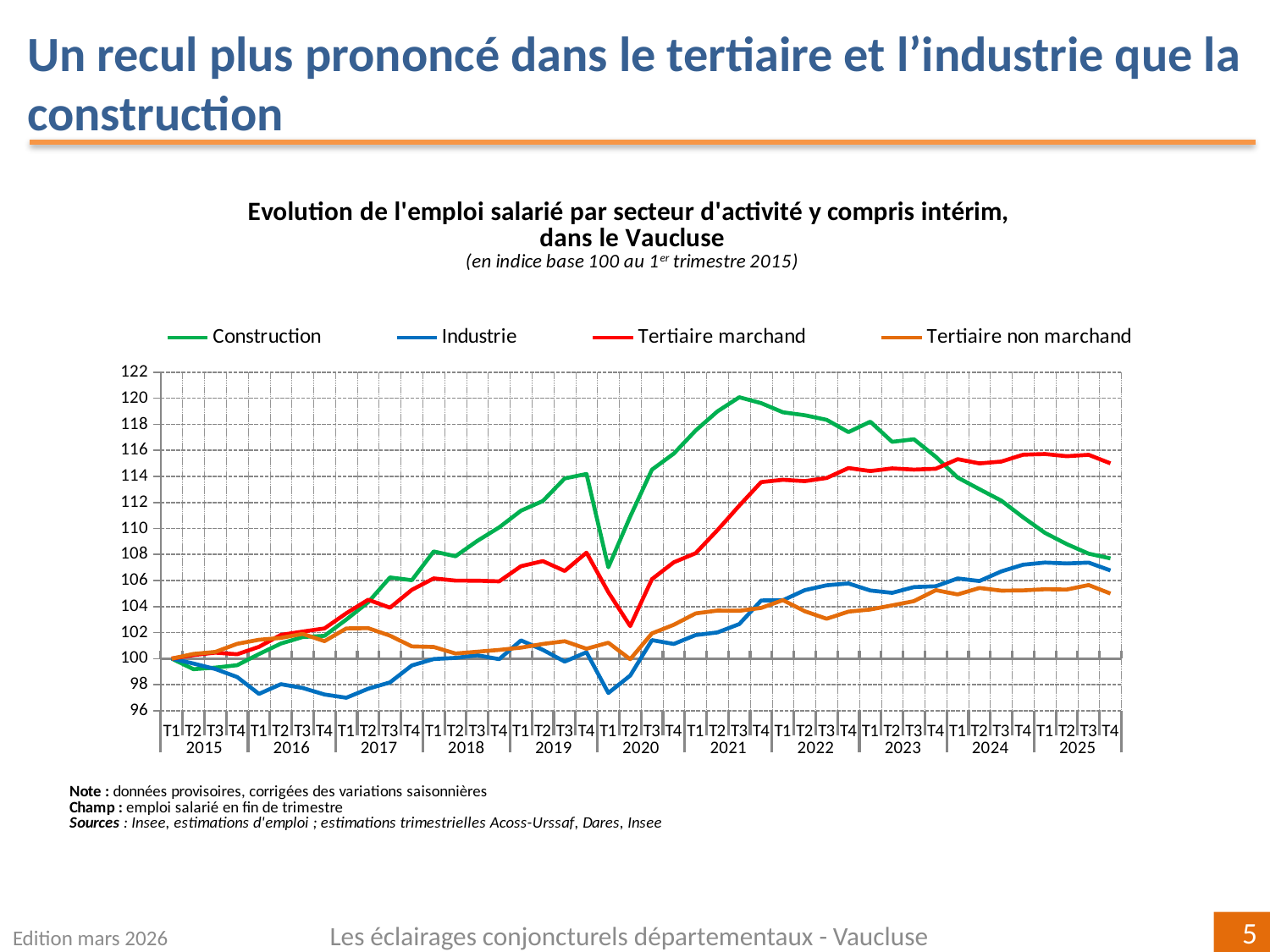
Which series has the highest value at T3 2021? Construction What is the base of the index used in the chart? 100 au 1er trimestre 2015 Is the value for Construction at T3 2021 greater or less than 118? greater What kind of chart is shown on the slide? line chart How many series does the legend list? 4 At T4 2025, which is larger: Tertiaire marchand or Construction? Tertiaire marchand Does the Construction series rise or fall between T3 2021 and T4 2025? fall How many years are shown along the x axis? 11 Which series has the lowest value at T1 2020? Industrie Is the value for Tertiaire non marchand at T4 2025 greater or less than 106? less Which series has the highest value at T4 2025? Tertiaire marchand Is the value for Industrie at T1 2020 greater or less than 100? less